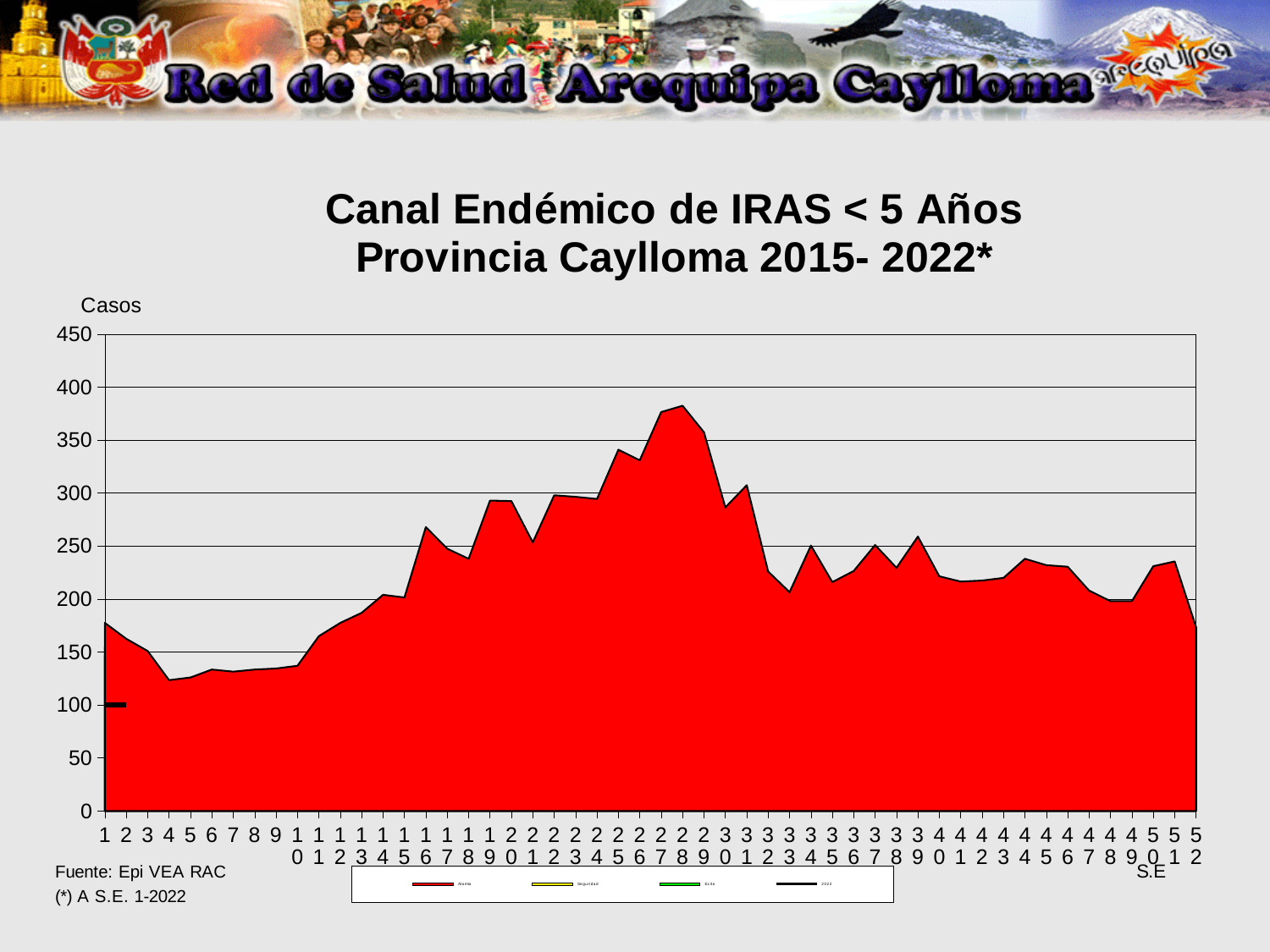
What source is cited below the chart? Fuente: Epi VEA RAC Does the red area rise or fall from week 1 to week 4? fall Is the peak value of the red area greater or less than 350? greater Is the value of the red area at week 1 greater or less than 150? greater How many series does the legend list? 4 Does the red area rise or fall overall from week 9 to week 28? rise What kind of chart is shown on the slide? area chart Is the value of the red area at week 33 greater or less than 250? less How many epidemiological weeks (S.E.) are shown on the x axis? 52 What is the title of the chart? Canal Endémico de IRAS < 5 Años Provincia Caylloma 2015- 2022*